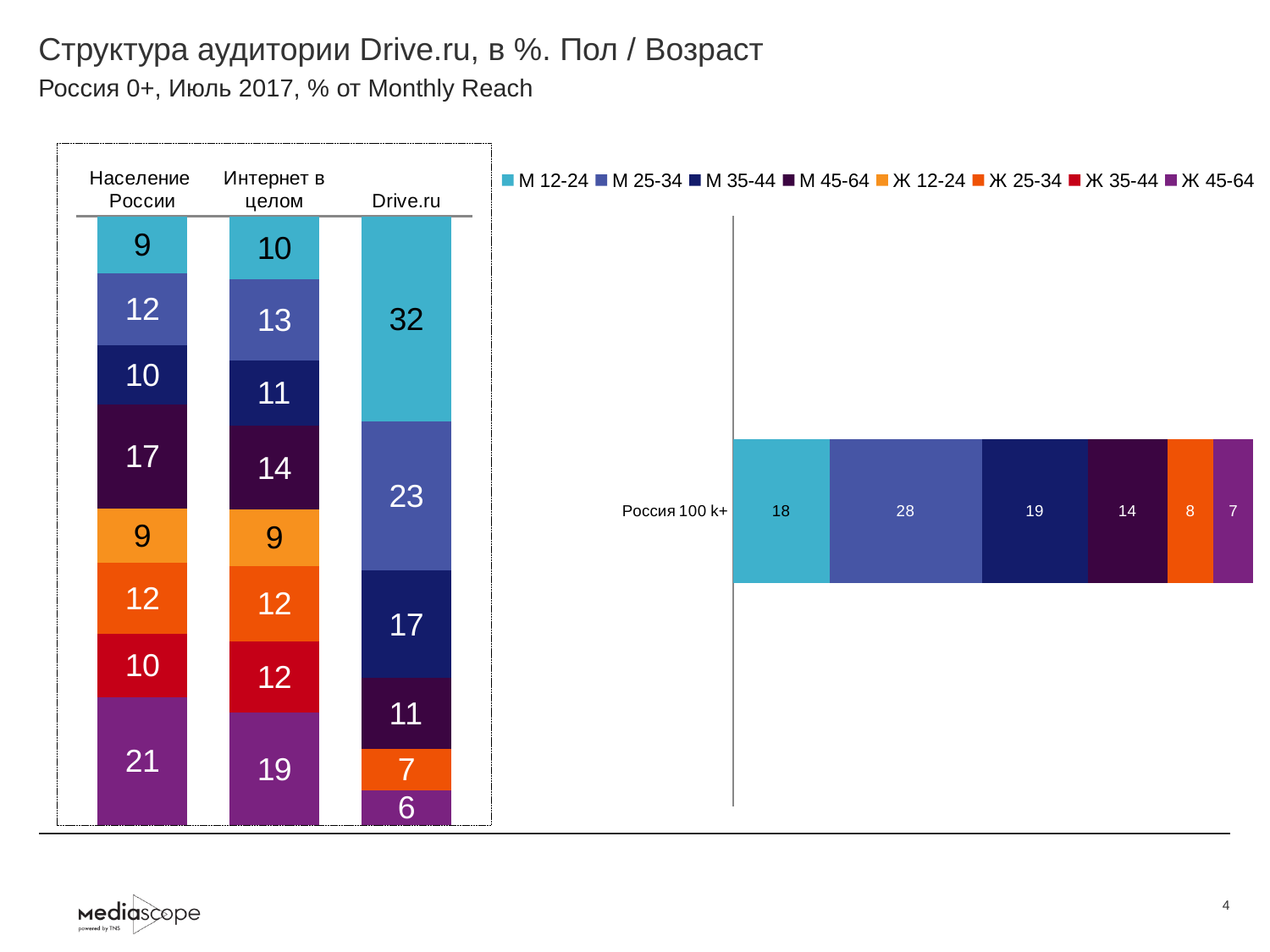
In the right chart, what is the value of the M 25-34 segment for Россия 100 k+? 28 In the left chart, which segment of the Drive.ru bar is the smallest? Ж 45-64 What kind of chart is the right chart? Stacked bar chart In the left chart, which segment of the Drive.ru bar is the largest? M 12-24 In the left chart, what is the difference between the M 12-24 values for Drive.ru and Население России? 23 In the right chart, what is the total of the labelled segments for Россия 100 k+? 94 How many series does the legend list? 8 In the left chart, what is the value of the M 45-64 segment for Интернет в целом? 14 In the left chart, which is larger: the Ж 45-64 value for Население России or for Интернет в целом? Население России In the left chart, what is the value of the Ж 45-64 segment for Население России? 21 In the left chart, what is the value of the M 12-24 segment for Drive.ru? 32 How many bars (categories) does the left chart show? 3